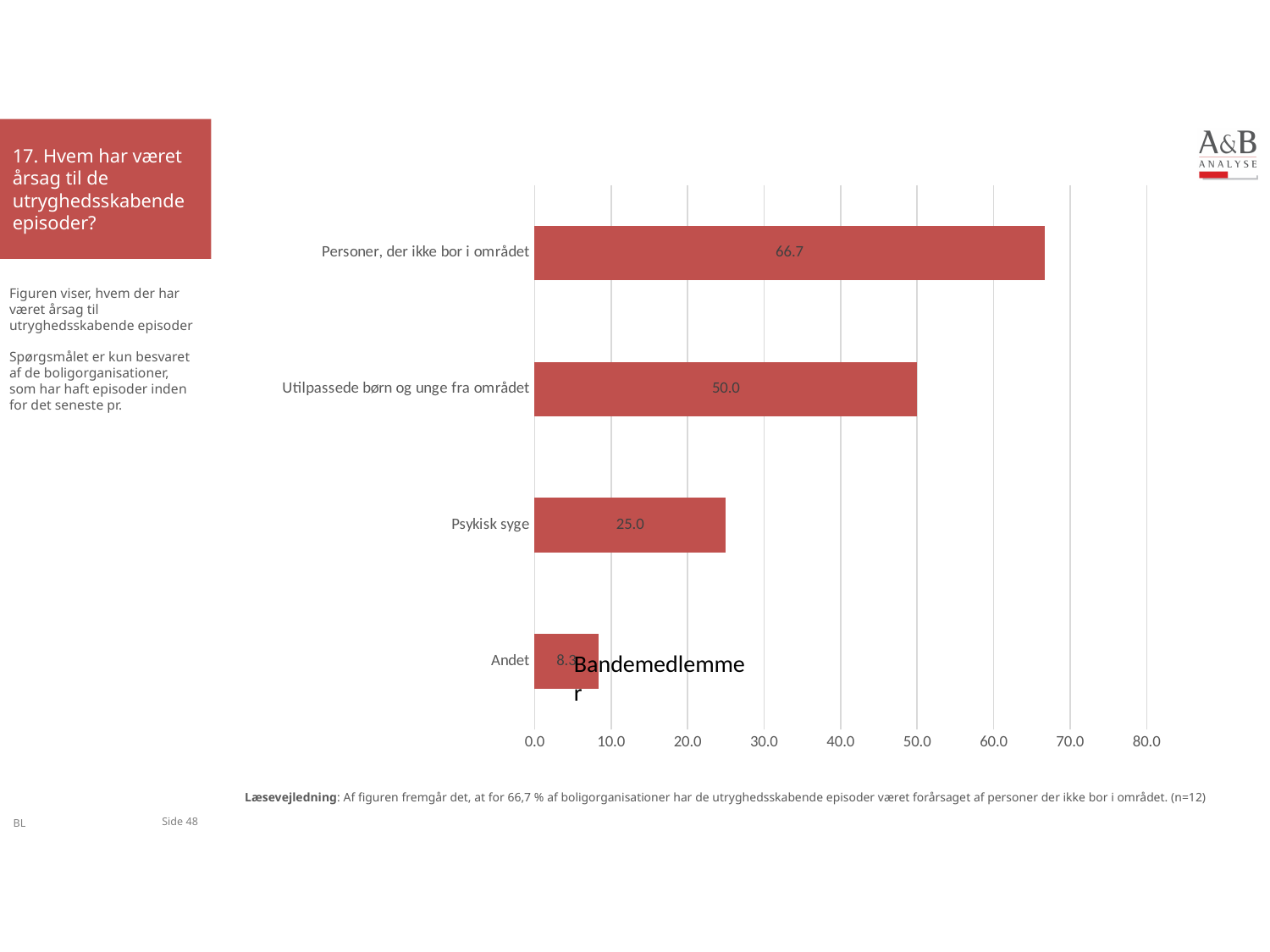
Which category has the highest value? Personer, der ikke bor i området Which category has the lowest value? Andet Is the value for "Personer, der ikke bor i området" greater or less than 60.0? greater What kind of chart is shown on the slide? bar chart Is the value for "Andet" greater or less than 10.0? less What is the value for "Utilpassede børn og unge fra området"? 50.0 What is the difference between the values for "Utilpassede børn og unge fra området" and "Psykisk syge"? 25.0 What is the difference between the values for "Personer, der ikke bor i området" and "Utilpassede børn og unge fra området"? 16.7 What is the value for "Psykisk syge"? 25.0 What is the value for "Personer, der ikke bor i området"? 66.7 How many categories are shown in the chart? 4 Which is larger, the value for "Psykisk syge" or the value for "Utilpassede børn og unge fra området"? Utilpassede børn og unge fra området